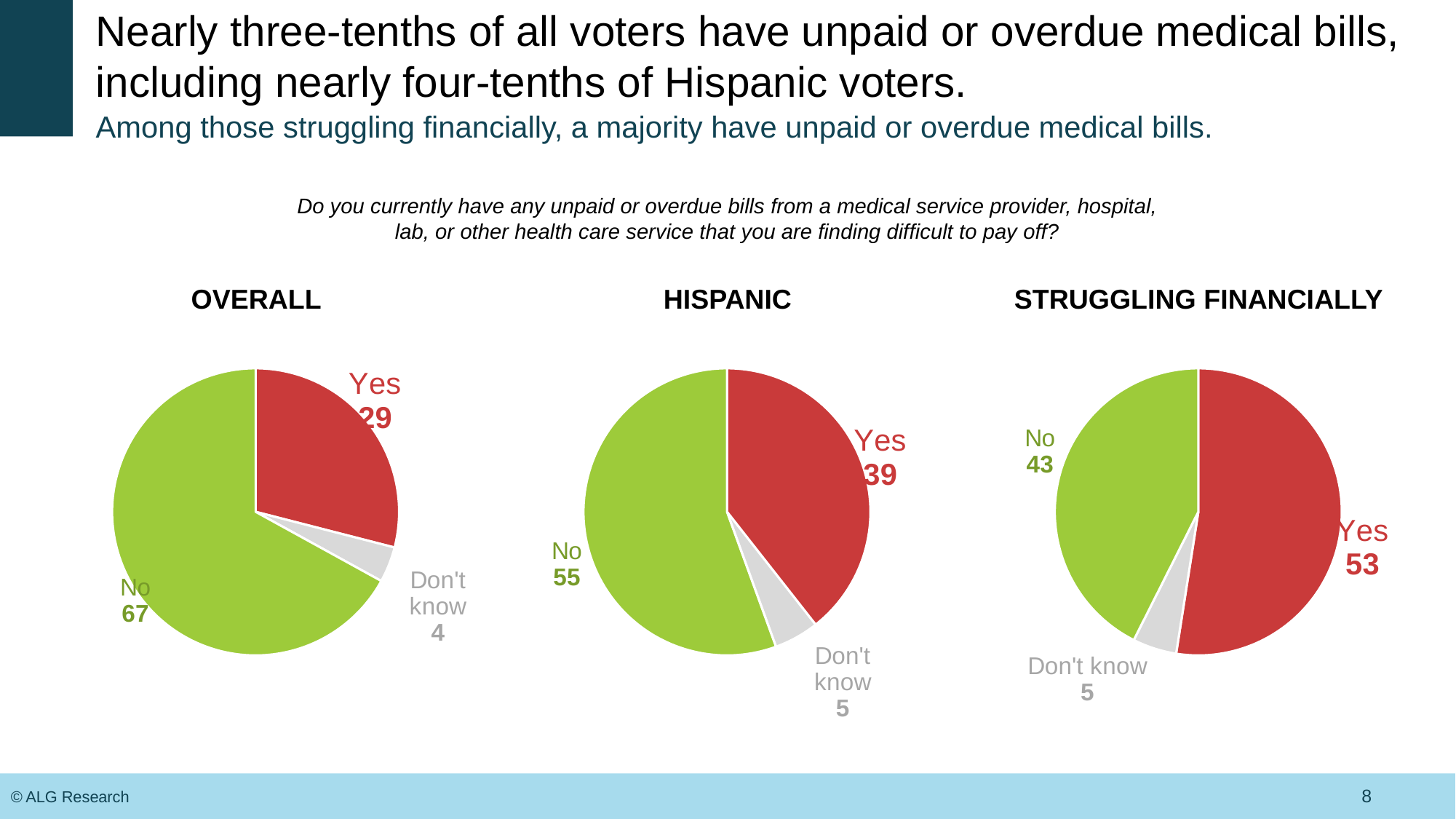
In the STRUGGLING FINANCIALLY pie chart, what is the value for Yes? 53 In the HISPANIC pie chart, what is the value for No? 55 In the OVERALL pie chart, which slice is the largest? No What kind of chart is the OVERALL chart? Pie chart In the OVERALL pie chart, what is the value for Yes? 29 What colour is the Yes slice in the STRUGGLING FINANCIALLY pie chart? Red In the HISPANIC pie chart, what is the value for Don't know? 5 In the OVERALL pie chart, what is the difference between No and Yes? 38 In the STRUGGLING FINANCIALLY pie chart, which slice is the smallest? Don't know In the HISPANIC pie chart, what is the difference between No and Yes? 16 In the STRUGGLING FINANCIALLY pie chart, which is larger, Yes or No? Yes How many slices does the HISPANIC pie chart have? 3